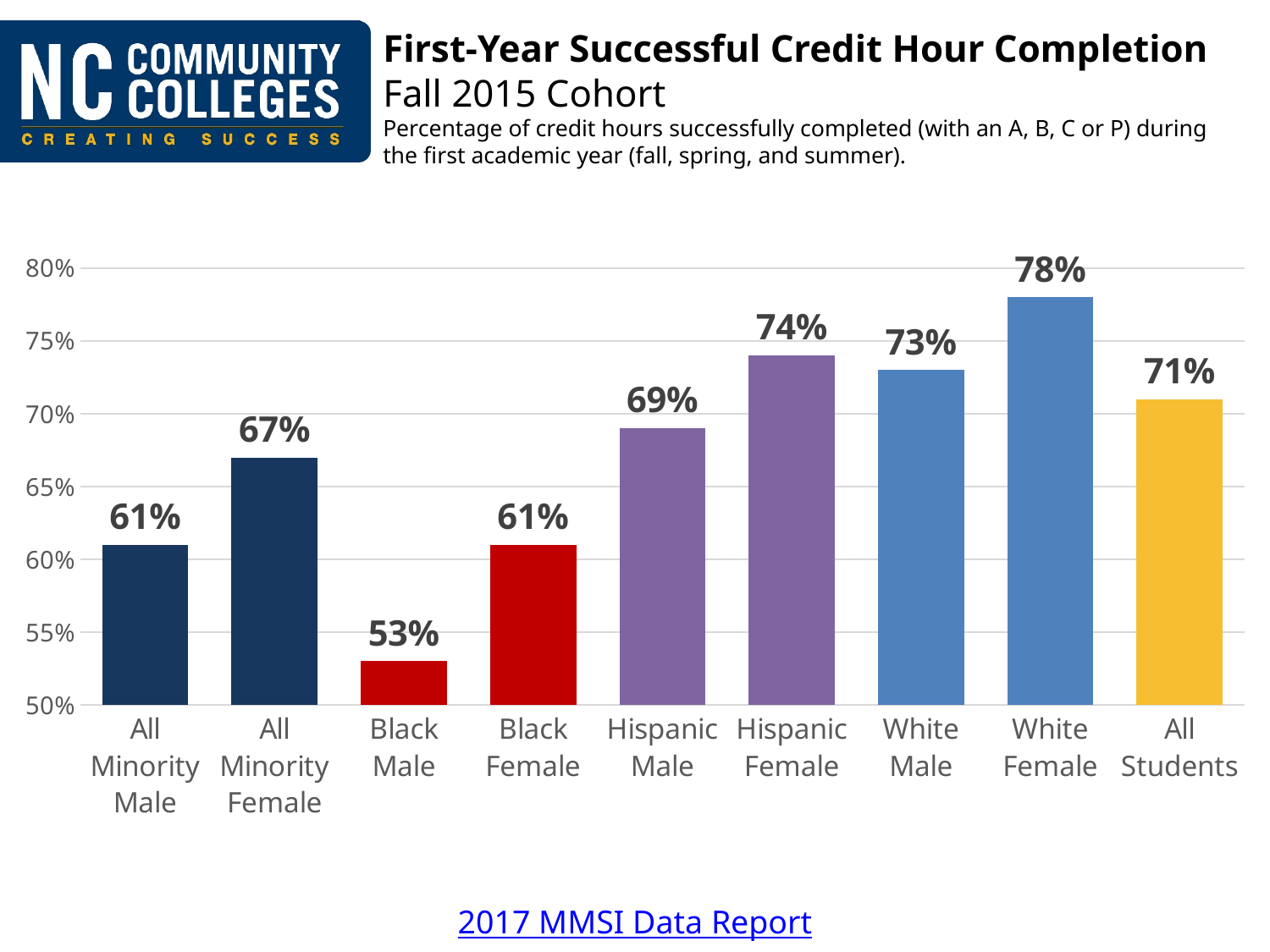
What is the title of the chart? First-Year Successful Credit Hour Completion How many categories are shown on the x axis? 9 What is the value shown for All Students? 71% What percentage is shown for Hispanic Female students? 74% What is the difference between the All Minority Female and All Minority Male values? 6% Which category has the lowest completion percentage? Black Male What is the first-year successful credit hour completion percentage for Black Male students? 53% Is the value for Black Female greater or less than 65%? less Which category has the highest completion percentage? White Female What is the difference between the White Female and Black Male percentages? 25% Which is larger, the value for Hispanic Male or the value for White Male? White Male What kind of chart is shown on the slide? bar chart